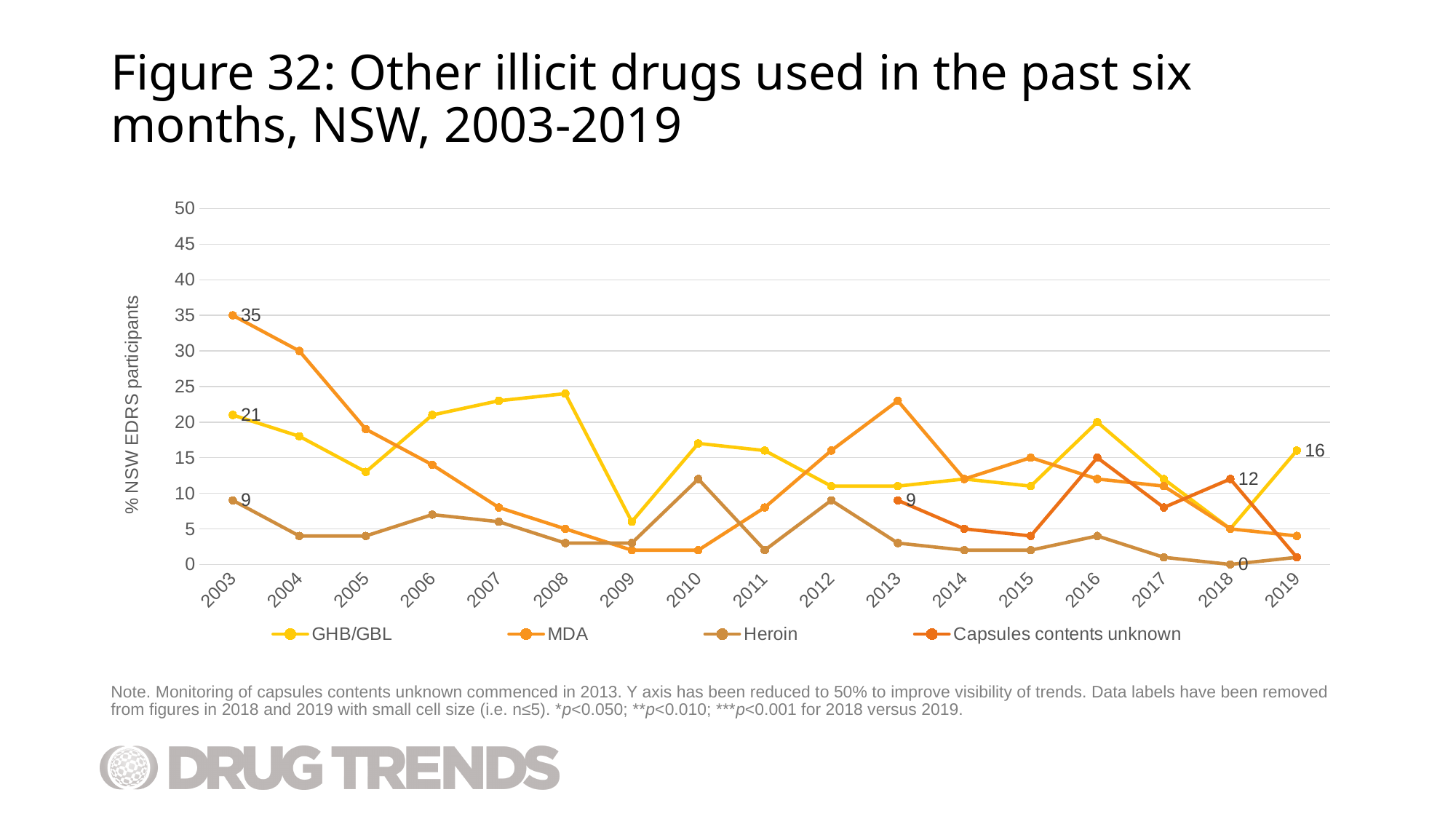
What is the value for MDA in 2003? 35 What kind of chart is shown on the slide? line chart What is the value for Heroin in 2003? 9 Which series has the highest value in 2003? MDA What is the label on the y axis? % NSW EDRS participants What is the value for GHB/GBL in 2003? 21 Is the value for MDA in 2004 greater or less than 25? greater How many years are shown along the x axis? 17 What is the value for Capsules contents unknown in 2018? 12 How many series does the legend list? 4 What is the value for GHB/GBL in 2019? 16 What is the difference between the MDA value and the GHB/GBL value in 2003? 14